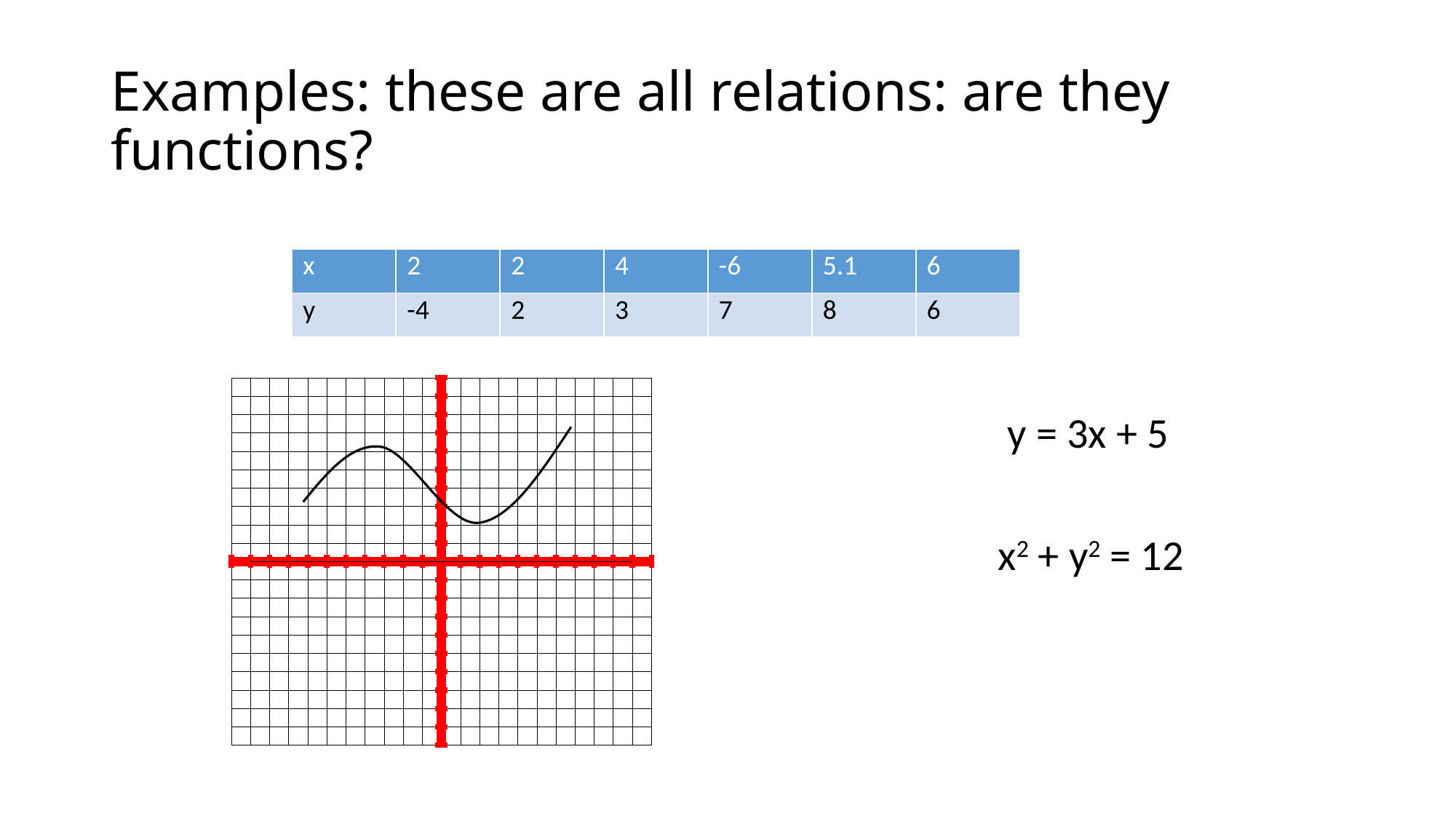
Does the plotted curve cross the vertical axis? yes How many curves are plotted on the coordinate grid? 1 In the table, what is the y value paired with x = -6? 7 How many x-y pairs does the table list? 6 In the table, what is the y value paired with x = 4? 3 What colour are the axes drawn on the coordinate grid? red In the table, what is the difference between the y values for x = 5.1 and x = 4? 5 In the table, what is the y value paired with x = 5.1? 8 Is the plotted curve entirely above or below the horizontal axis? above What kind of chart is shown on the grid at the lower left of the slide? a line graph (a curve plotted on a coordinate grid) Moving left to right, does the plotted curve rise, fall, or rise and fall? it rises, then falls, then rises again In the table, which x value appears twice? 2